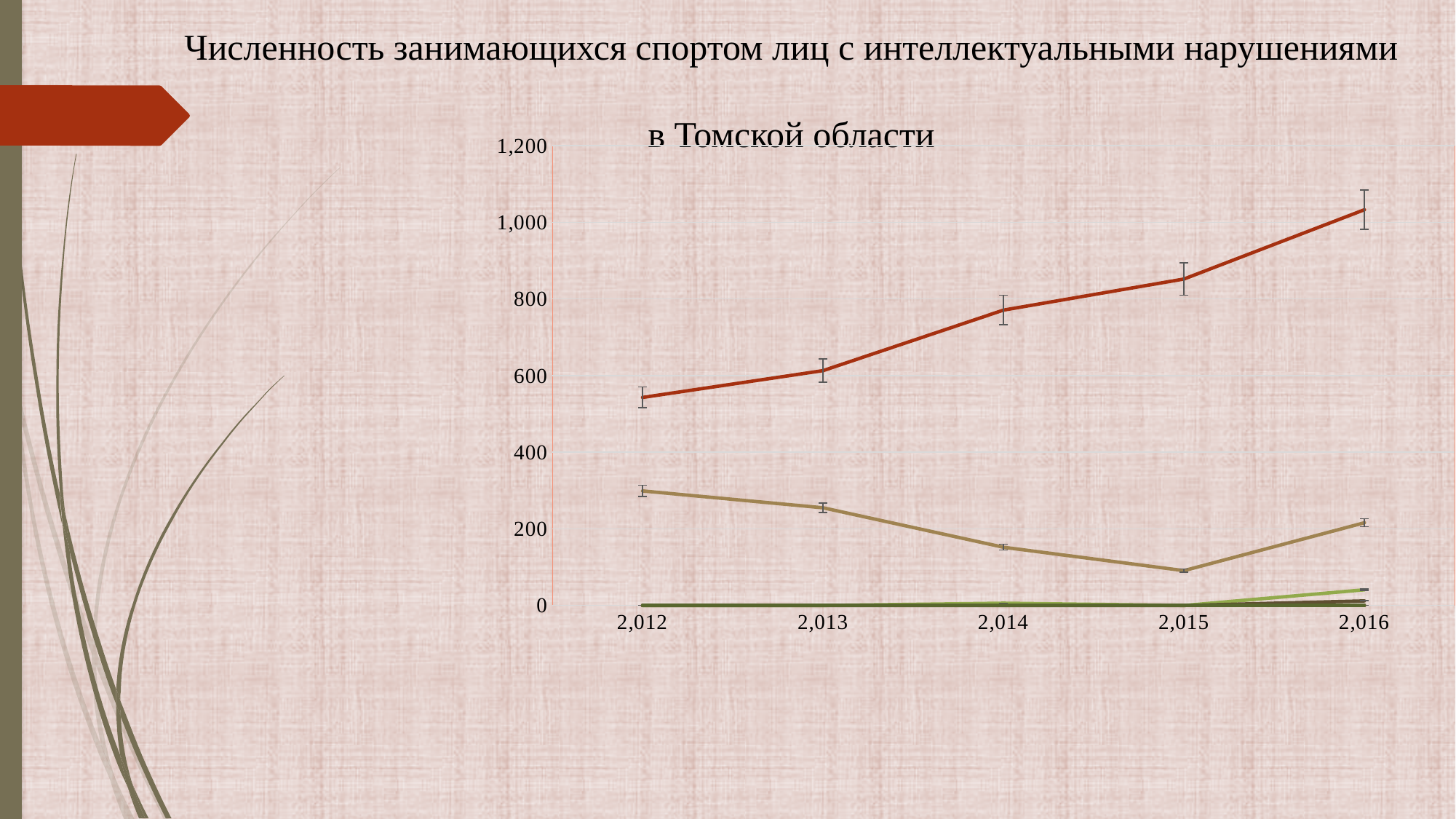
Does the red line rise or fall from 2,012 to 2,016? rises How many years are plotted along the x axis? 5 In which year does the tan (light brown) line reach its lowest value? 2,015 Is the value of the red line in 2,015 greater or less than 800? greater Is the value of the tan (light brown) line in 2,012 greater or less than 200? greater Is the value of the red line in 2,016 greater or less than 1,000? greater What is the title of the chart? Численность занимающихся спортом лиц с интеллектуальными нарушениями в Томской области In 2,014, which line has the larger value, the red line or the tan (light brown) line? the red line What kind of chart is shown on the slide? line chart In which year does the red line reach its highest value? 2,016